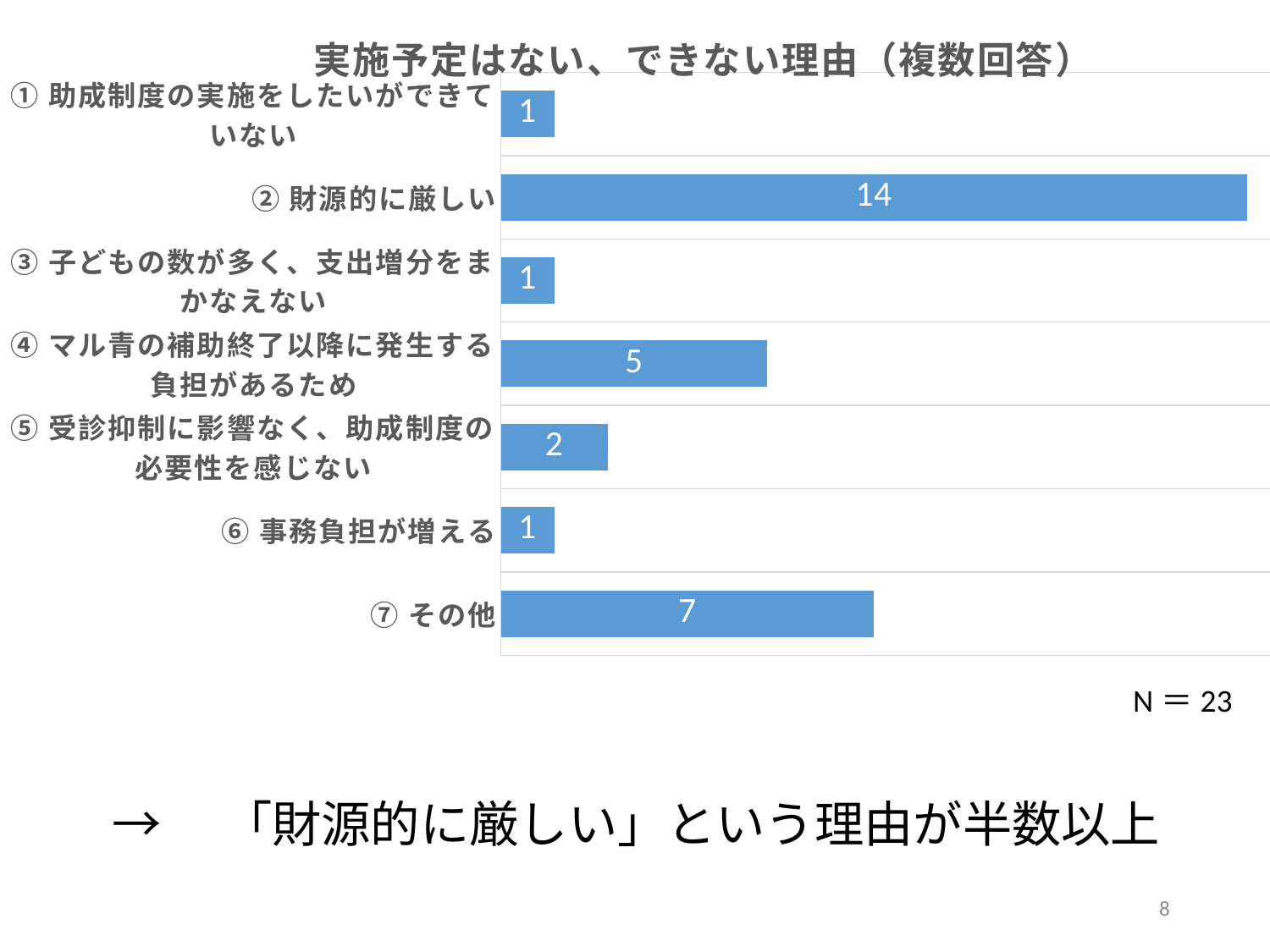
What kind of chart is shown on the slide? Bar chart How many categories are shown in the chart? 7 What is the difference between the values for ② 財源的に厳しい and ⑦ その他? 7 What is the difference between the values for ④ マル青の補助終了以降に発生する負担があるため and ⑤ 受診抑制に影響なく、助成制度の必要性を感じない? 3 What is the value for ⑤ 受診抑制に影響なく、助成制度の必要性を感じない? 2 What is the title of the chart? 実施予定はない、できない理由（複数回答） What is the value for ② 財源的に厳しい? 14 Which is larger, the value for ⑦ その他 or the value for ④ マル青の補助終了以降に発生する負担があるため? ⑦ その他 What is the value for ④ マル青の補助終了以降に発生する負担があるため? 5 Which category has the highest value? ② 財源的に厳しい What is the value for ⑦ その他? 7 How many categories have a value of 1? 3